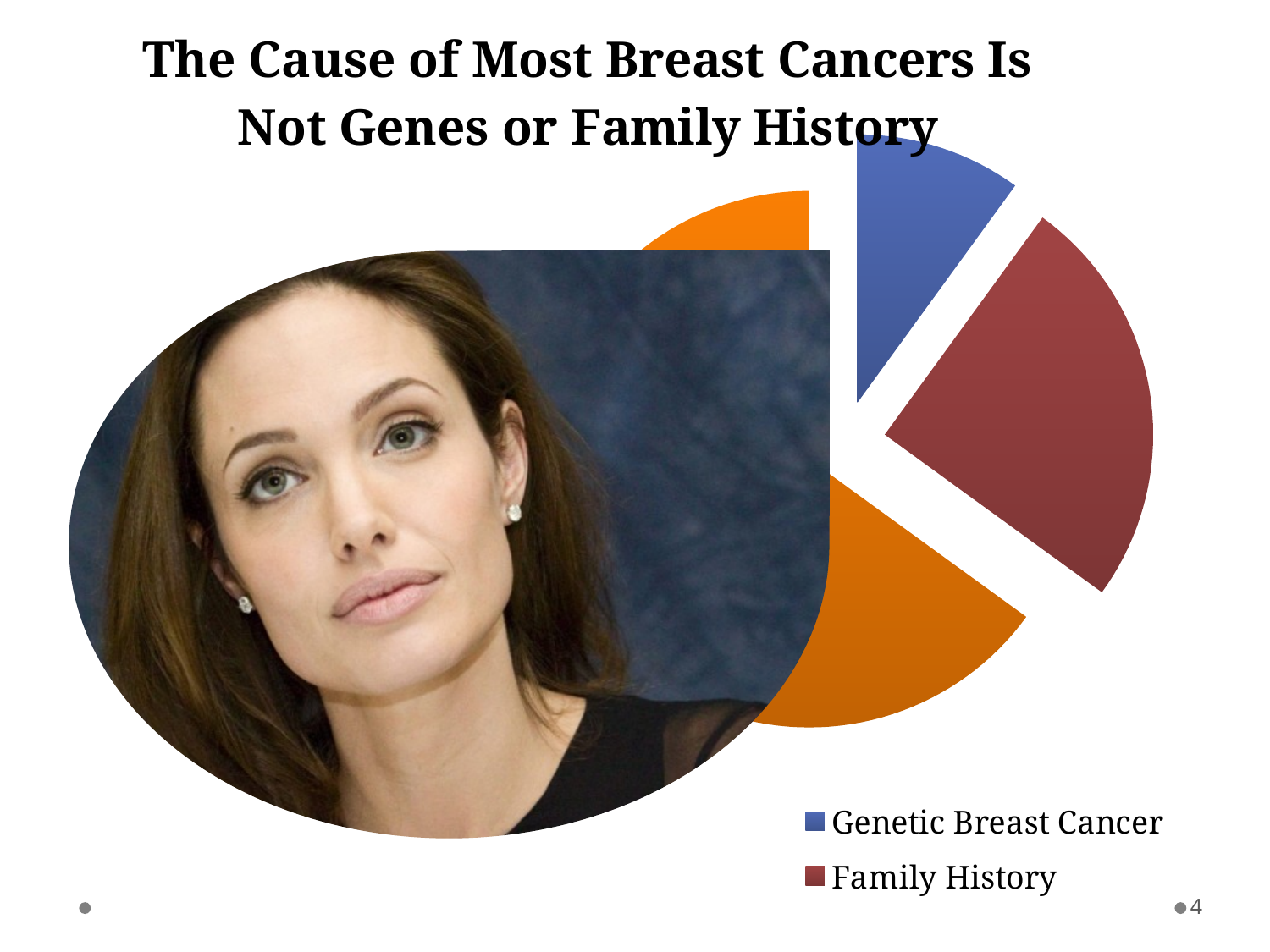
How many entries does the legend of the pie chart list? 2 How many slices does the pie chart have? 3 Which legend category has the smallest slice in the pie chart? Genetic Breast Cancer What colour represents Genetic Breast Cancer in the pie chart? blue Which slice is larger, Family History or Genetic Breast Cancer? Family History What kind of chart is shown on the slide? pie chart What colour represents Family History in the pie chart? red